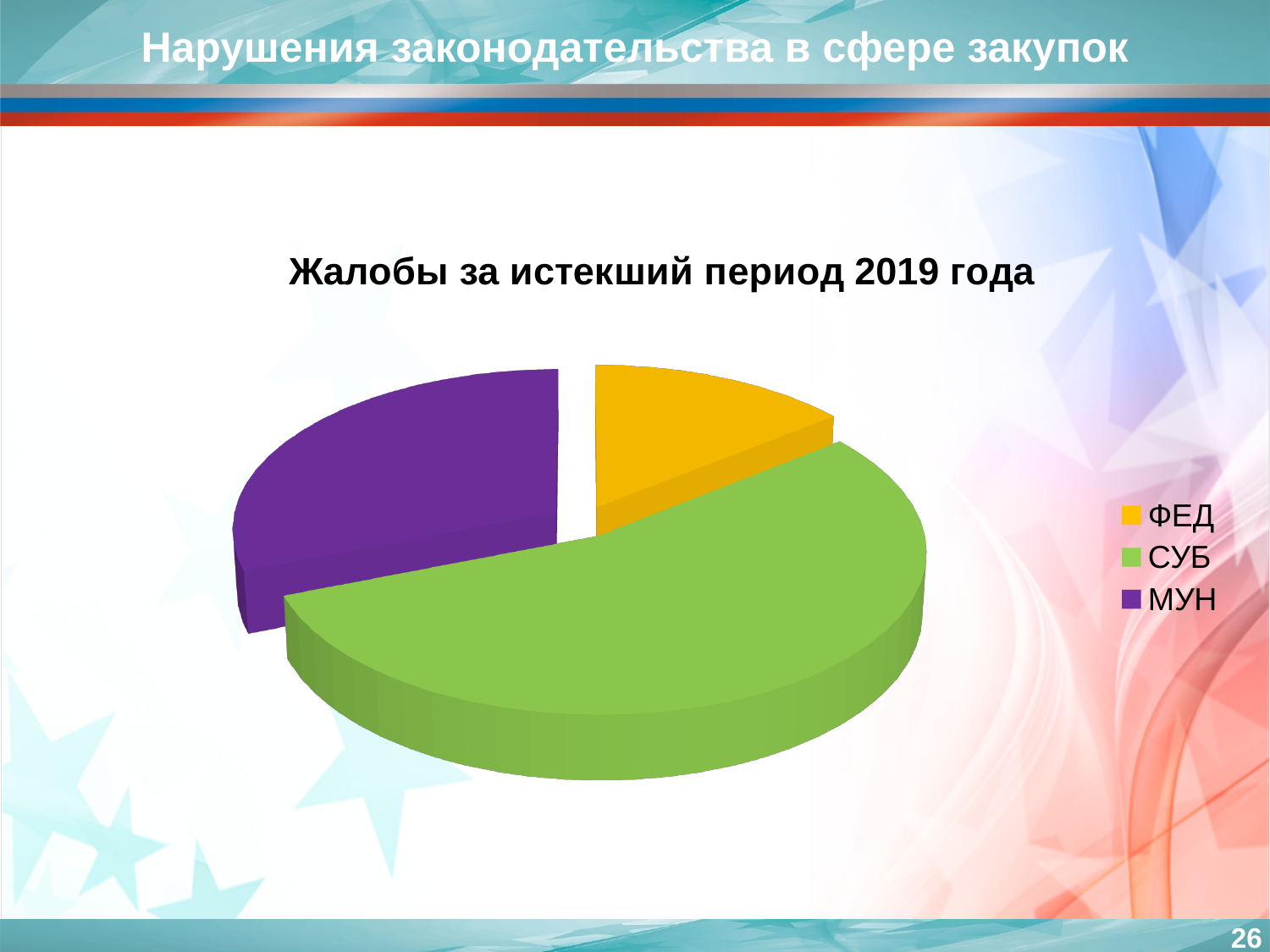
What is the title of the chart? Жалобы за истекший период 2019 года How many entries does the legend list? 3 Which colour represents the МУН category in the pie chart? purple What kind of chart is shown on the slide? pie chart Which category has the largest slice of the pie? СУБ How many slices does the pie chart have? 3 Which slice is larger, ФЕД or МУН? МУН Which category has the smallest slice of the pie? ФЕД Which slice is larger, СУБ or МУН? СУБ